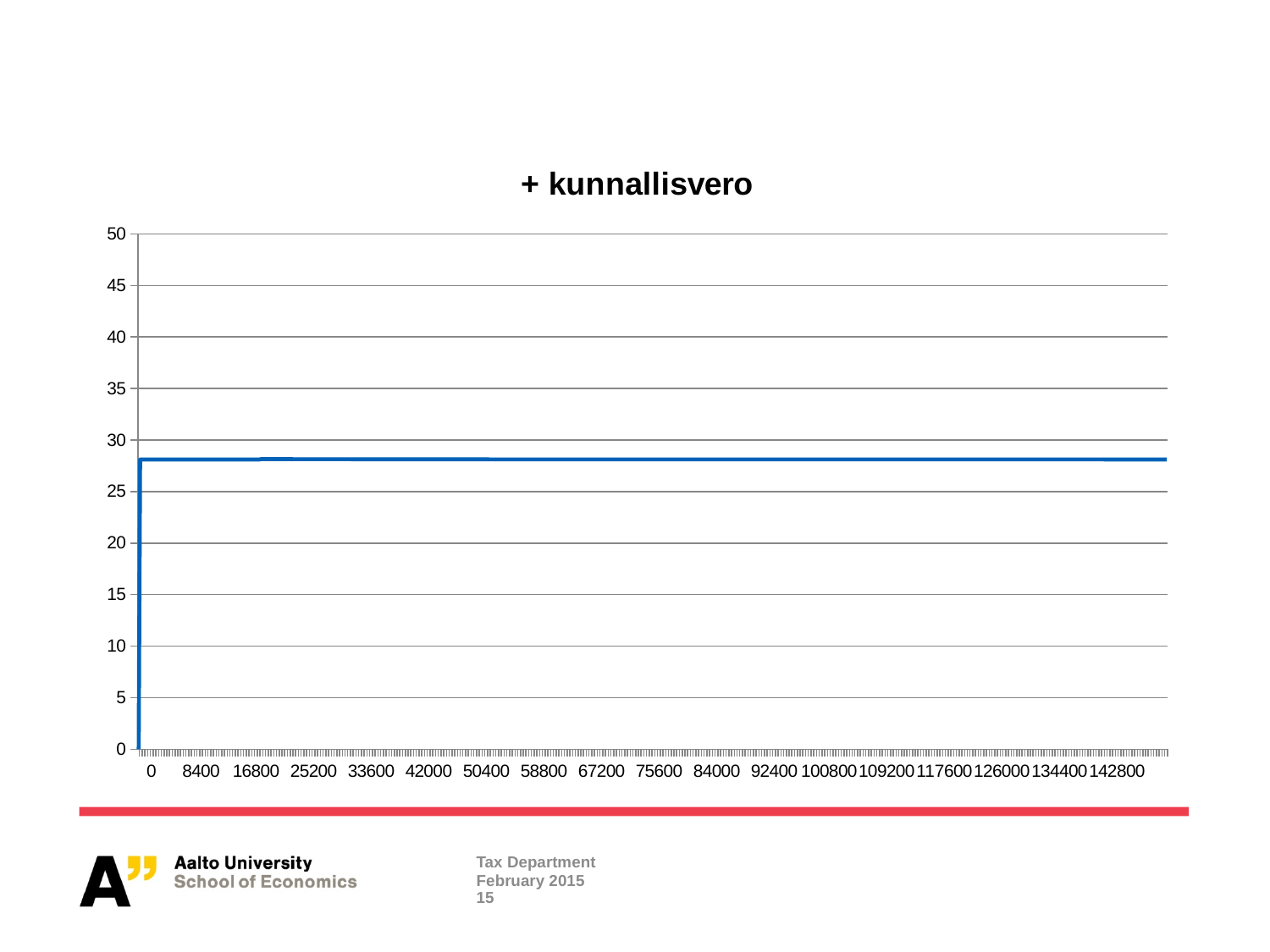
What is the highest value shown on the y axis? 50 Is the value of the line at 8400 greater or less than 40? less What kind of chart is shown on the slide? line chart After the initial jump at the start, does the line rise, fall, or stay flat along the x axis? stay flat Is the value of the line at 84000 greater or less than 25? greater What is the title of the chart? + kunnallisvero Is the value of the line at 142800 greater or less than 30? less